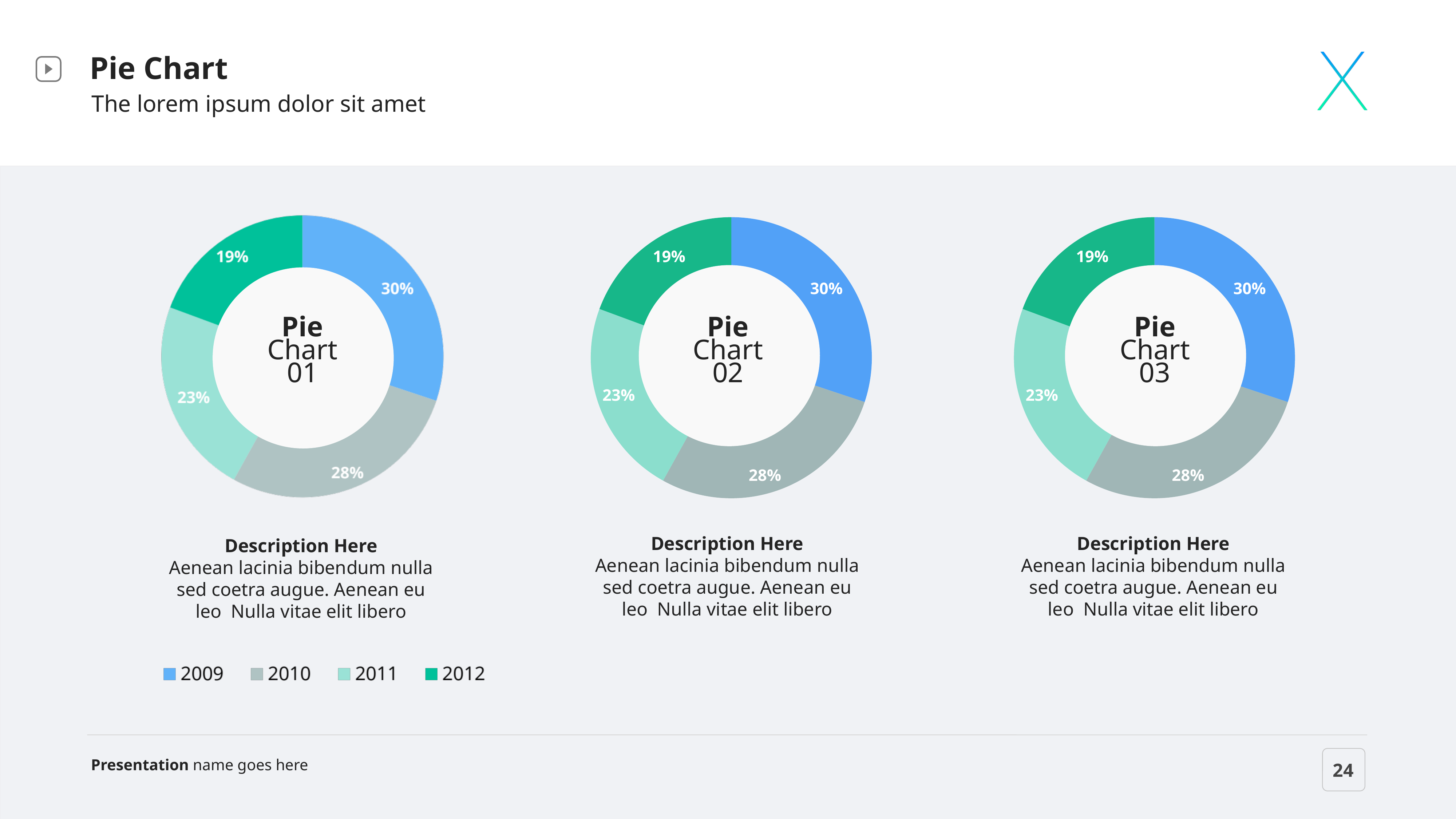
In Pie Chart 01, which is larger, the 2011 slice or the 2012 slice? 2011 In Pie Chart 02, what share does 2011 have? 23% How many slices does Pie Chart 02 have? 4 In Pie Chart 02, what is the combined share of 2010 and 2011? 51% How many entries does the legend at the bottom of the slide list? 4 Which colour represents 2010 in the legend? Gray In Pie Chart 02, which year has the smallest slice? 2012 In Pie Chart 03, what share does 2012 have? 19% What kind of chart is Pie Chart 03? Pie chart In Pie Chart 01, which year has the largest slice? 2009 In Pie Chart 01, what share does 2009 have? 30% In Pie Chart 03, what is the difference between the 2009 and 2010 slices? 2%